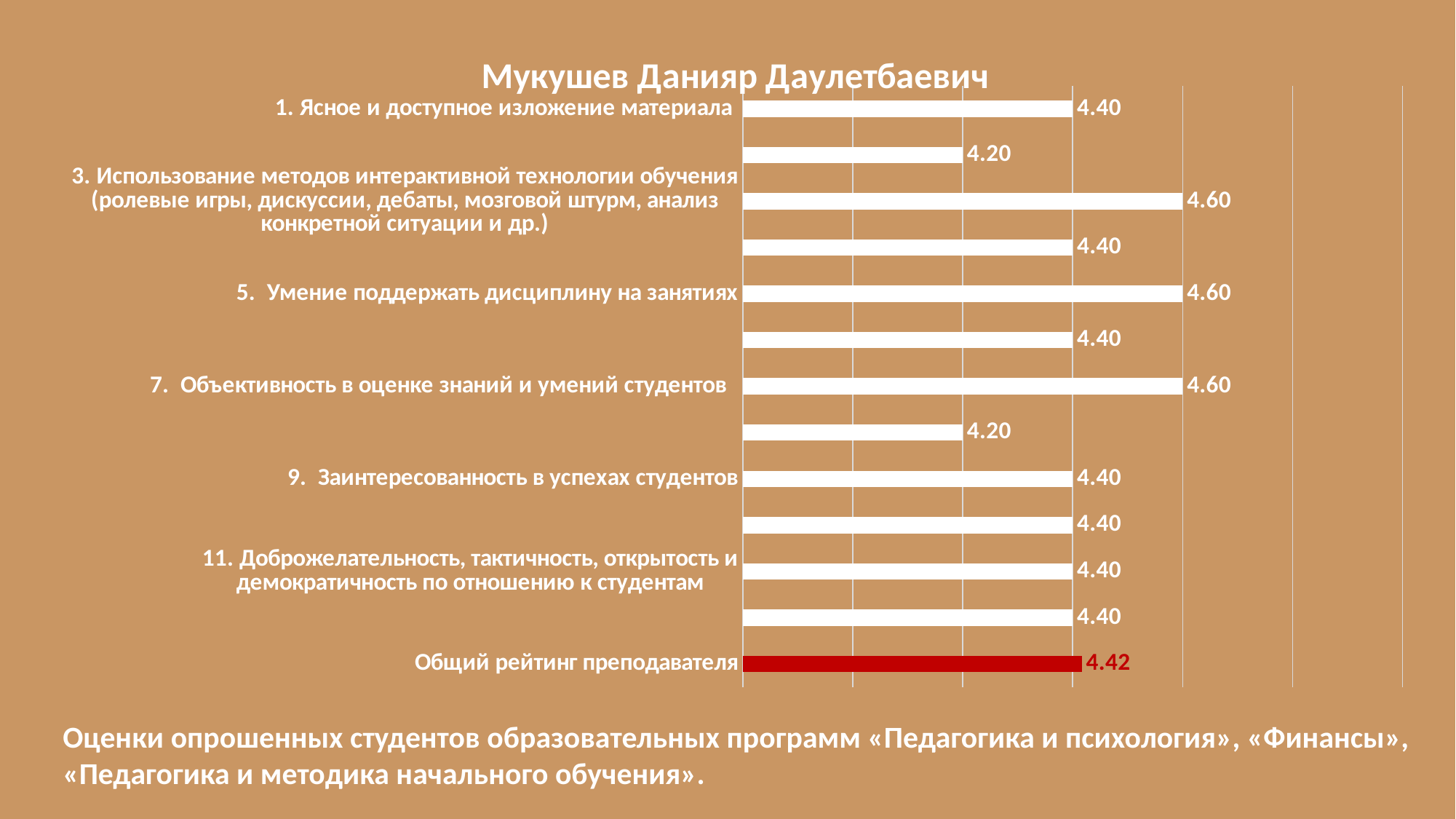
Which is larger: the value for "7. Объективность в оценке знаний и умений студентов" or the value for "Общий рейтинг преподавателя"? 7. Объективность в оценке знаний и умений студентов What is the difference between the value for "5. Умение поддержать дисциплину на занятиях" and the value for "9. Заинтересованность в успехах студентов"? 0.20 What type of chart is shown on the slide? bar chart What is the lowest value shown in the chart? 4.20 What is the value for "1. Ясное и доступное изложение материала"? 4.40 What is the highest value shown in the chart? 4.60 What is the title of the chart? Мукушев Данияр Даулетбаевич What is the value for "7. Объективность в оценке знаний и умений студентов"? 4.60 What is the value for "9. Заинтересованность в успехах студентов"? 4.40 What is the value for "5. Умение поддержать дисциплину на занятиях"? 4.60 What is the value for "Общий рейтинг преподавателя"? 4.42 How many bars are plotted in the chart? 13